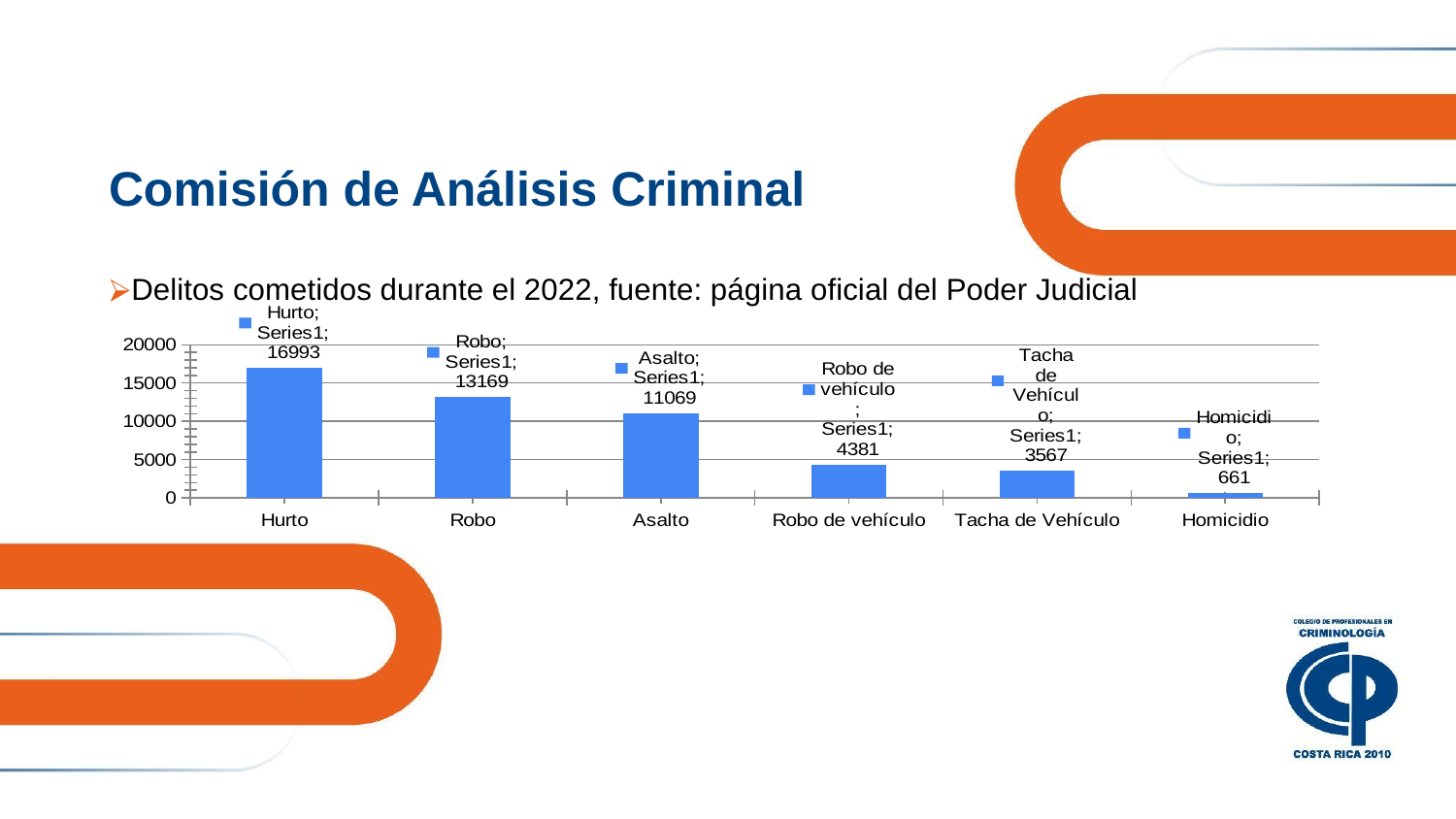
What is the value for Hurto? 16993 What is the difference between the values for Hurto and Robo? 3824 Is the value for Asalto greater or less than 10000? greater What is the difference between the values for Robo de vehículo and Tacha de Vehículo? 814 What kind of chart is shown on the slide? bar chart Do the values rise or fall from left to right along the x axis? fall Which is larger, the value for Asalto or the value for Robo? Robo How many categories are shown on the x axis? 6 Which category has the highest value? Hurto What is the value for Homicidio? 661 What is the value for Robo de vehículo? 4381 Which category has the lowest value? Homicidio